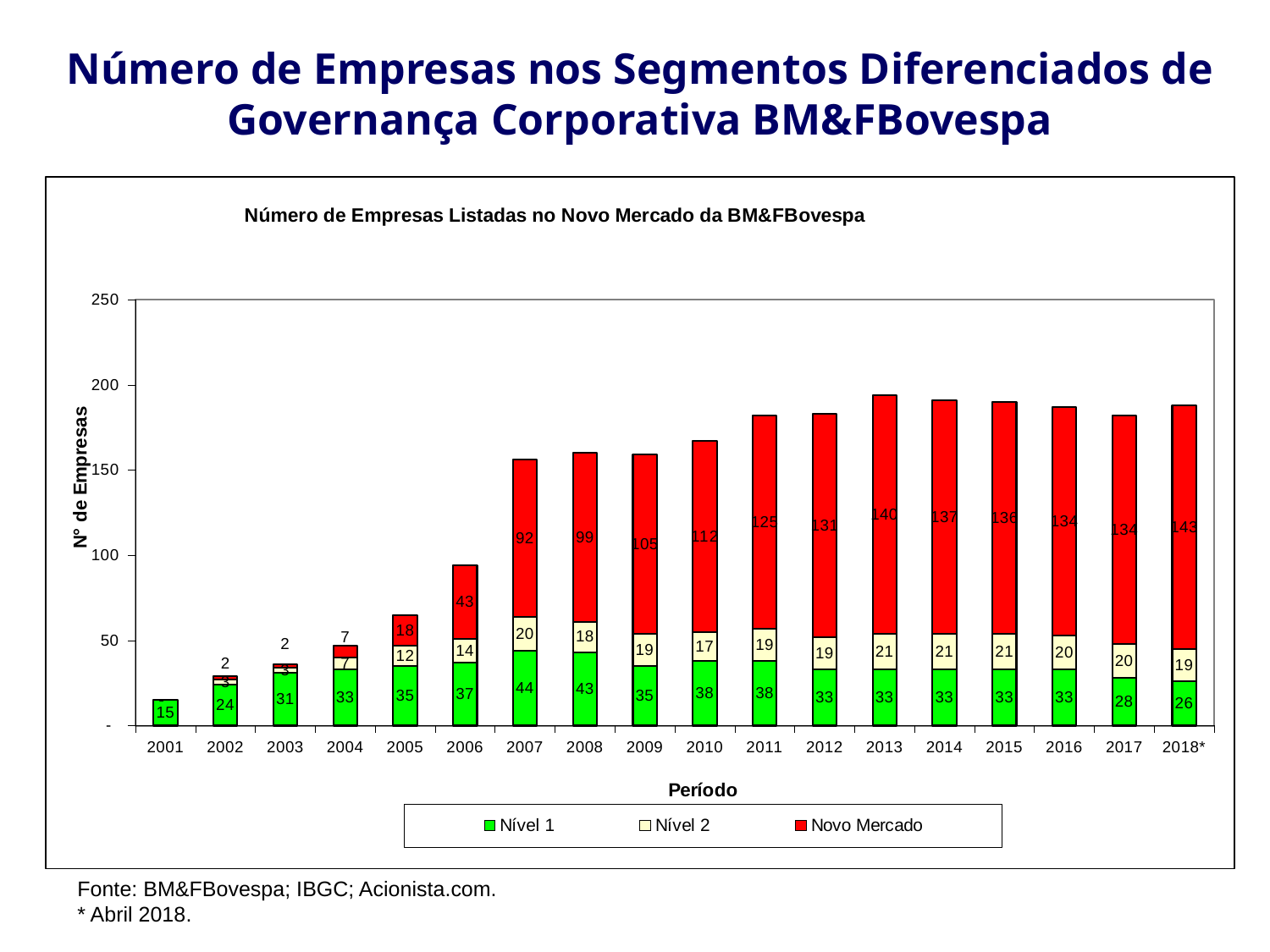
Which series is shown in red in the legend? Novo Mercado In which year is the Novo Mercado value highest? 2018* What is the Nível 2 value for 2005? 12 What is the Nível 1 value for 2007? 44 In which year is the Nível 1 value highest? 2007 How many periods (years) are shown on the x axis? 18 What kind of chart is shown on the slide? stacked bar chart What is the total of the stacked bar for 2013? 194 What is the Novo Mercado value for 2013? 140 How many series does the legend list? 3 What is the difference between the Novo Mercado values for 2018* and 2017? 9 Which is larger, the Novo Mercado value for 2011 or for 2012? 2012